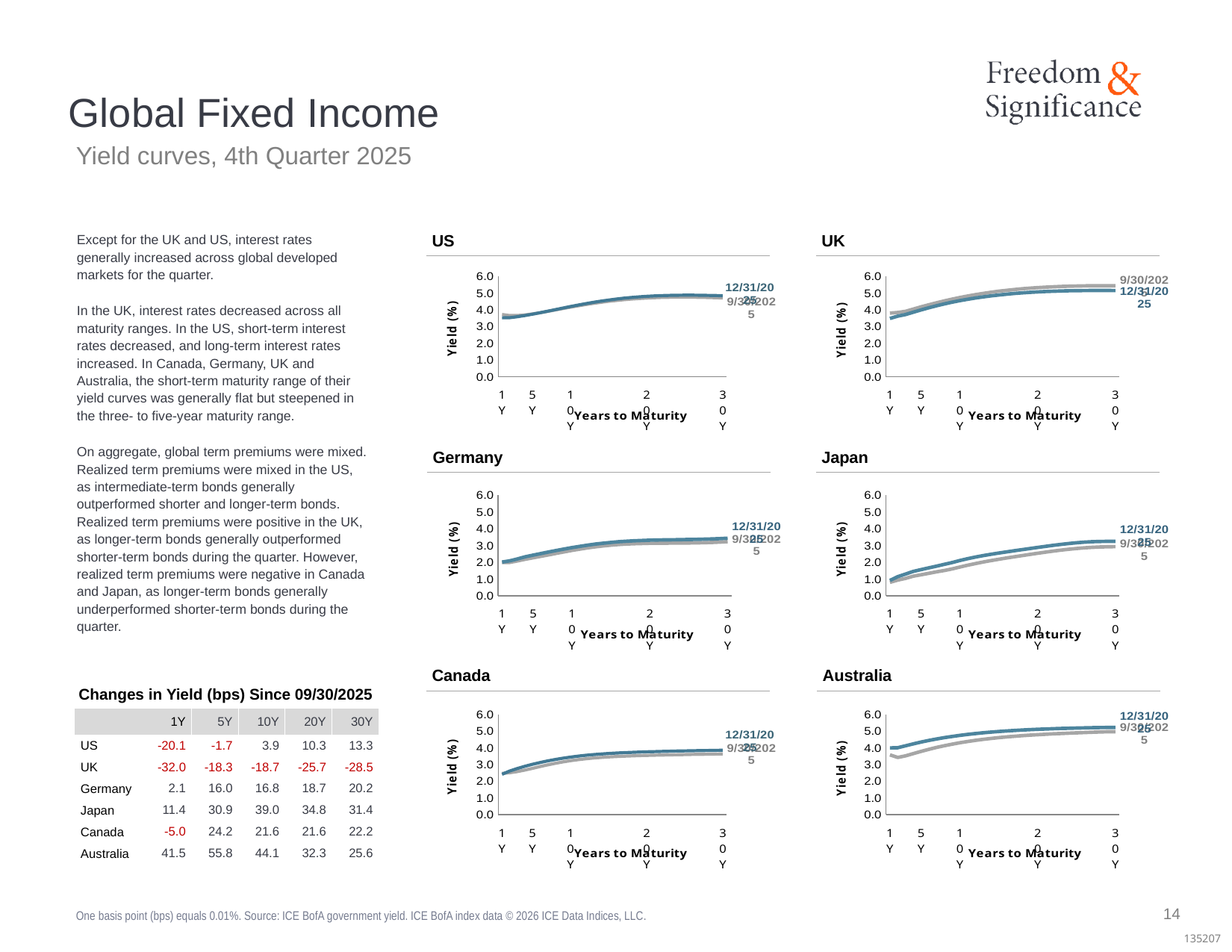
In the Japan chart, which series is higher at 30Y, 12/31/2025 or 9/30/2025? 12/31/2025 In the Japan chart, is the 9/30/2025 yield at 1Y greater or less than 2.0? less What kind of chart is the US chart? line chart How many maturity points are shown on the x axis of the Germany chart? 5 In the Germany chart, is the 12/31/2025 yield at 1Y greater or less than 3.0? less What is the x-axis label on the Canada chart? Years to Maturity In the US chart, is the 12/31/2025 yield at 1Y greater or less than 4.0? less In the Japan chart, do the 12/31/2025 yields rise or fall as years to maturity increase? rise In the Australia chart, which series is higher at 10Y, 12/31/2025 or 9/30/2025? 12/31/2025